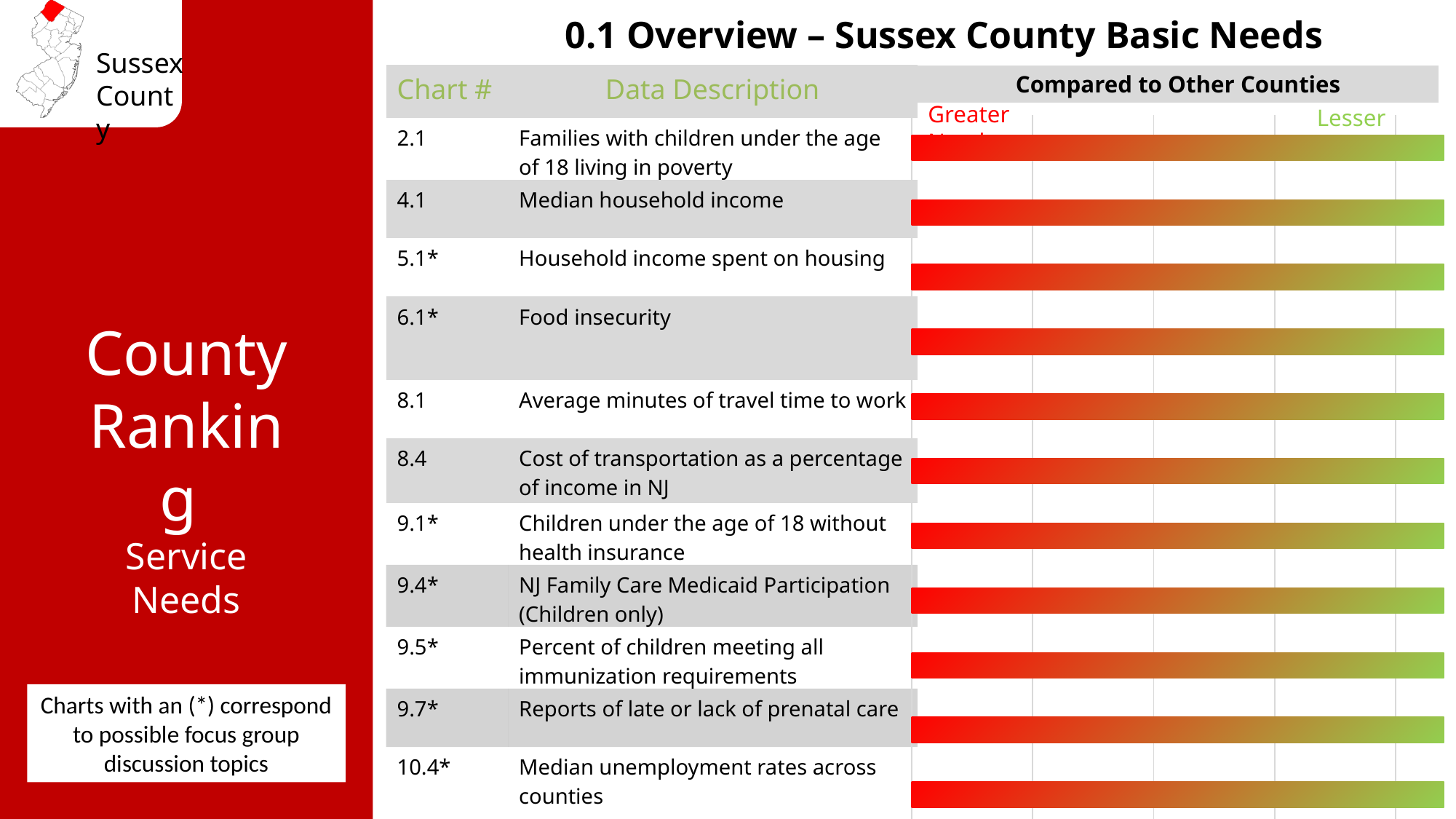
What kind of chart is used in the 'Compared to Other Counties' section? bar chart How many data description rows (categories) are shown with bars in the 'Compared to Other Counties' chart? 11 Which data description is listed for chart 10.4*? Median unemployment rates across counties What is the heading above the bars on the right side of the slide? Compared to Other Counties Which data description is listed for chart 8.1? Average minutes of travel time to work Which colour is at the 'Greater' need end of each bar, and which at the 'Lesser' end? Red at Greater, green at Lesser Which chart number is listed for 'Median household income'? 4.1 Which chart number is listed for 'Food insecurity'? 6.1*